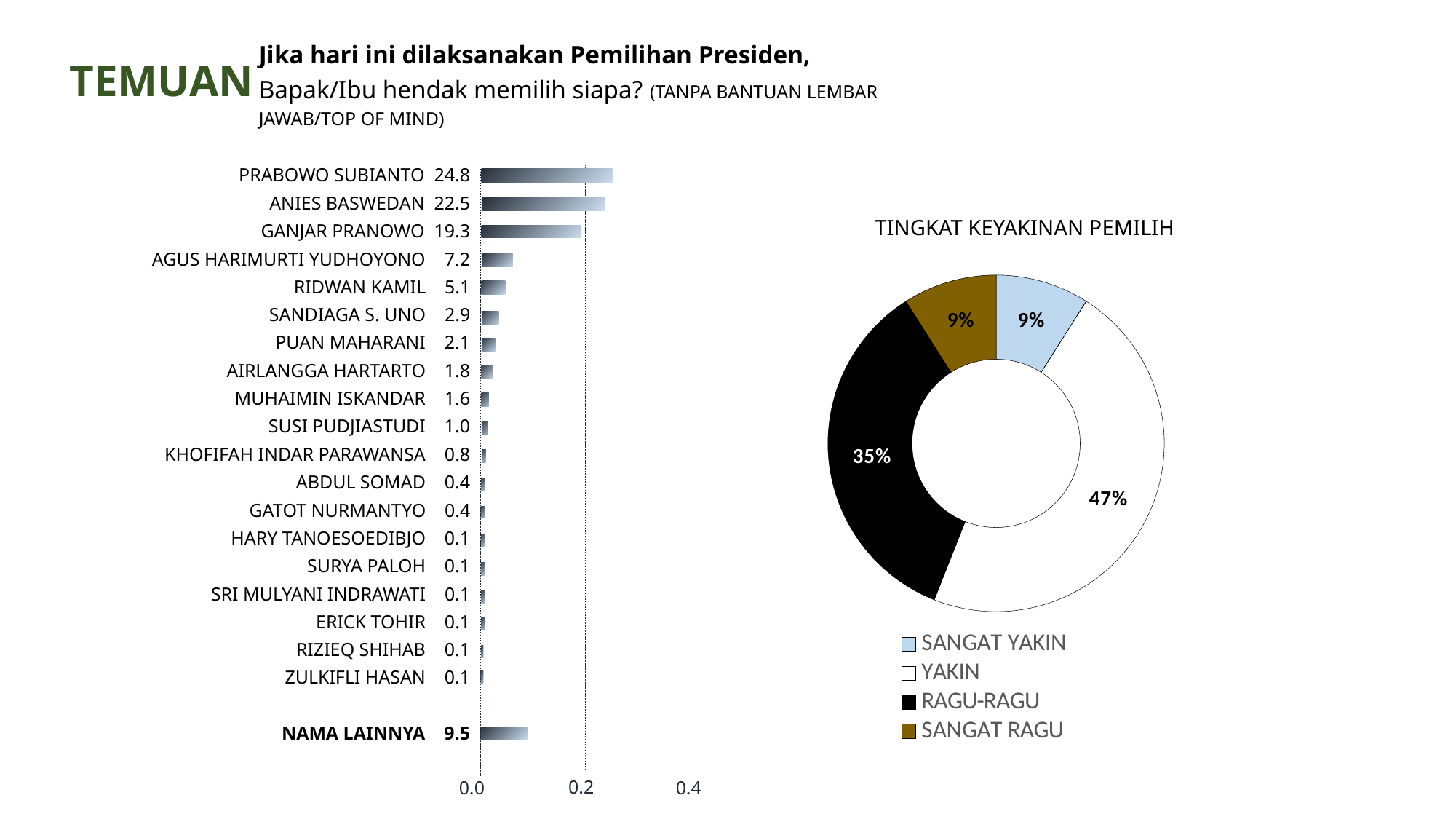
In the TINGKAT KEYAKINAN PEMILIH chart, what is the share for YAKIN? 47% In the bar chart on the left, what is the difference between the values for PRABOWO SUBIANTO and ANIES BASWEDAN? 2.3 What kind of chart is the chart on the left of the slide? Bar chart In the bar chart on the left, what is the value for GANJAR PRANOWO? 19.3 In the bar chart on the left, what is the value for PRABOWO SUBIANTO? 24.8 In the TINGKAT KEYAKINAN PEMILIH chart, what is the share for RAGU-RAGU? 35% In the bar chart on the left, which is larger, the value for AGUS HARIMURTI YUDHOYONO or the value for RIDWAN KAMIL? AGUS HARIMURTI YUDHOYONO How many entries does the legend of the TINGKAT KEYAKINAN PEMILIH chart list? 4 In the bar chart on the left, how many categories (including NAMA LAINNYA) are listed? 20 In the TINGKAT KEYAKINAN PEMILIH chart, which category has the largest share? YAKIN In the bar chart on the left, what is the value for NAMA LAINNYA? 9.5 In the bar chart on the left, which candidate has the highest value? PRABOWO SUBIANTO